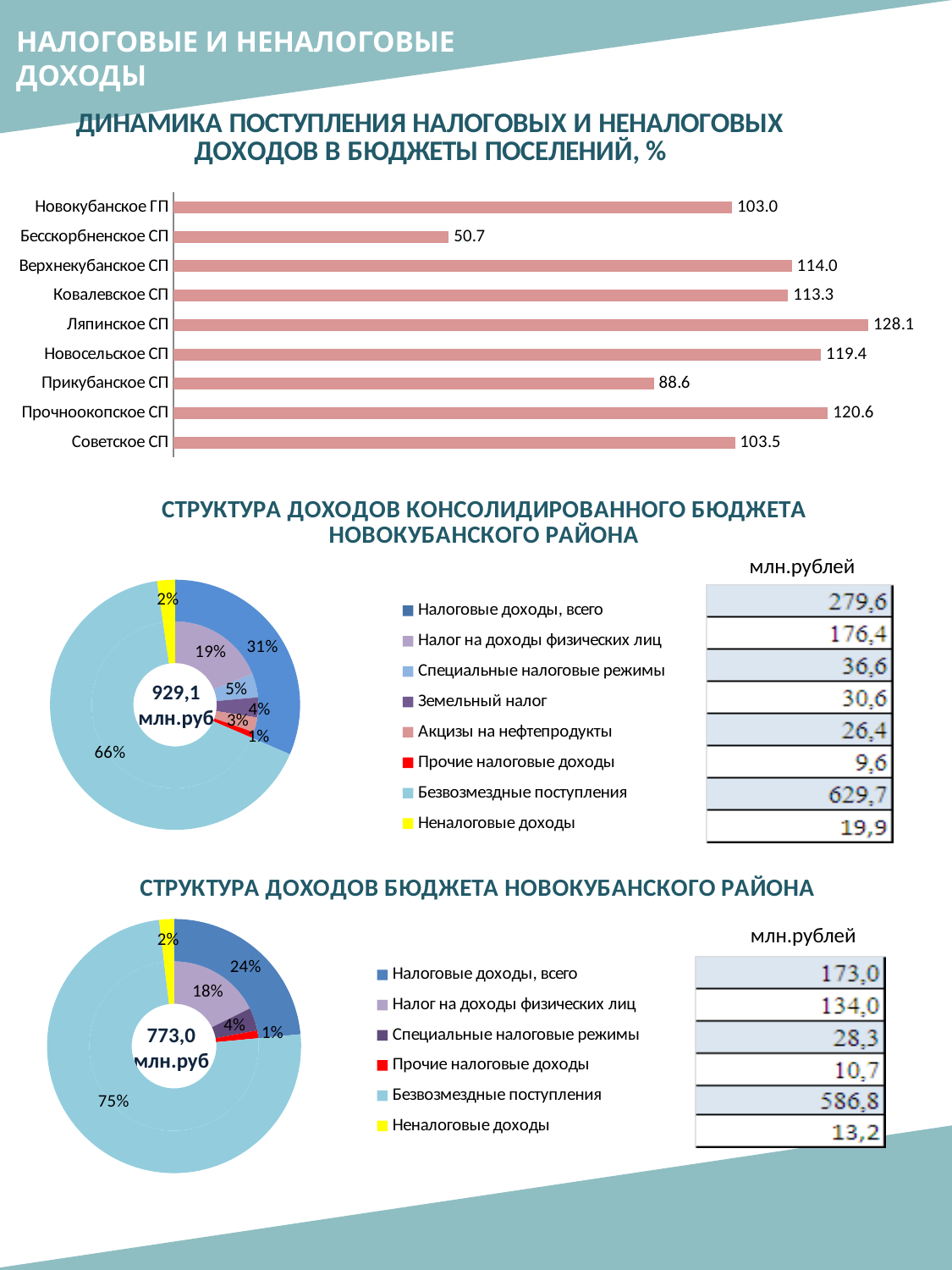
In the doughnut chart 'Структура доходов бюджета Новокубанского района', what share do Налоговые доходы, всего have? 24% In the bar chart 'Динамика поступления налоговых и неналоговых доходов в бюджеты поселений, %', what is the difference between the values for Ляпинское СП and Бесскорбненское СП? 77.4 In the bar chart 'Динамика поступления налоговых и неналоговых доходов в бюджеты поселений, %', what is the value for Ляпинское СП? 128.1 How many entries does the legend of the chart 'Структура доходов консолидированного бюджета Новокубанского района' list? 8 What kind of chart is used for 'Динамика поступления налоговых и неналоговых доходов в бюджеты поселений, %'? Bar chart In the doughnut chart 'Структура доходов консолидированного бюджета Новокубанского района', what is the total shown in the centre? 929,1 млн.руб In the bar chart 'Динамика поступления налоговых и неналоговых доходов в бюджеты поселений, %', which is larger: the value for Прочноокопское СП or for Новосельское СП? Прочноокопское СП In the bar chart 'Динамика поступления налоговых и неналоговых доходов в бюджеты поселений, %', which settlement has the lowest value? Бесскорбненское СП In the doughnut chart 'Структура доходов консолидированного бюджета Новокубанского района', what share do Безвозмездные поступления have? 66% In the table next to the chart 'Структура доходов бюджета Новокубанского района', what is the value in млн.рублей for Безвозмездные поступления? 586,8 In the bar chart 'Динамика поступления налоговых и неналоговых доходов в бюджеты поселений, %', which settlement has the highest value? Ляпинское СП How many settlements are shown in the bar chart 'Динамика поступления налоговых и неналоговых доходов в бюджеты поселений, %'? 9